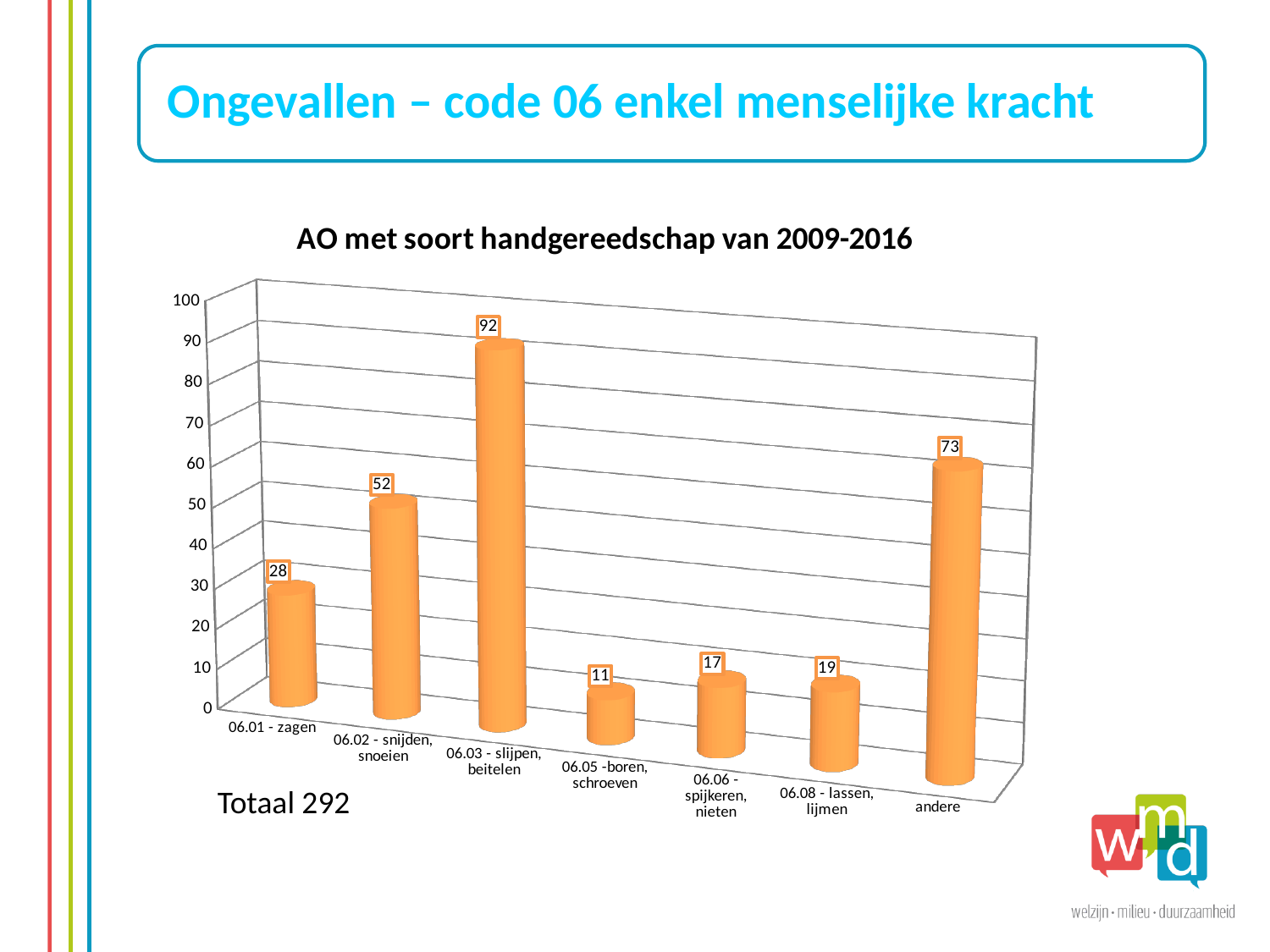
What is the value for 06.05 -boren, schroeven? 11 How many categories are shown on the x axis? 7 Which is larger, the value for 06.01 - zagen or the value for 06.02 - snijden, snoeien? 06.02 - snijden, snoeien What is the value for 06.03 - slijpen, beitelen? 92 What kind of chart is shown? bar chart Which category has the highest value? 06.03 - slijpen, beitelen What is the title of the chart? AO met soort handgereedschap van 2009-2016 What is the value for 06.06 - spijkeren, nieten? 17 Is the value for 06.08 - lassen, lijmen greater or less than 30? less What is the difference between the values for 06.03 - slijpen, beitelen and andere? 19 What is the value for andere? 73 Which category has the lowest value? 06.05 -boren, schroeven